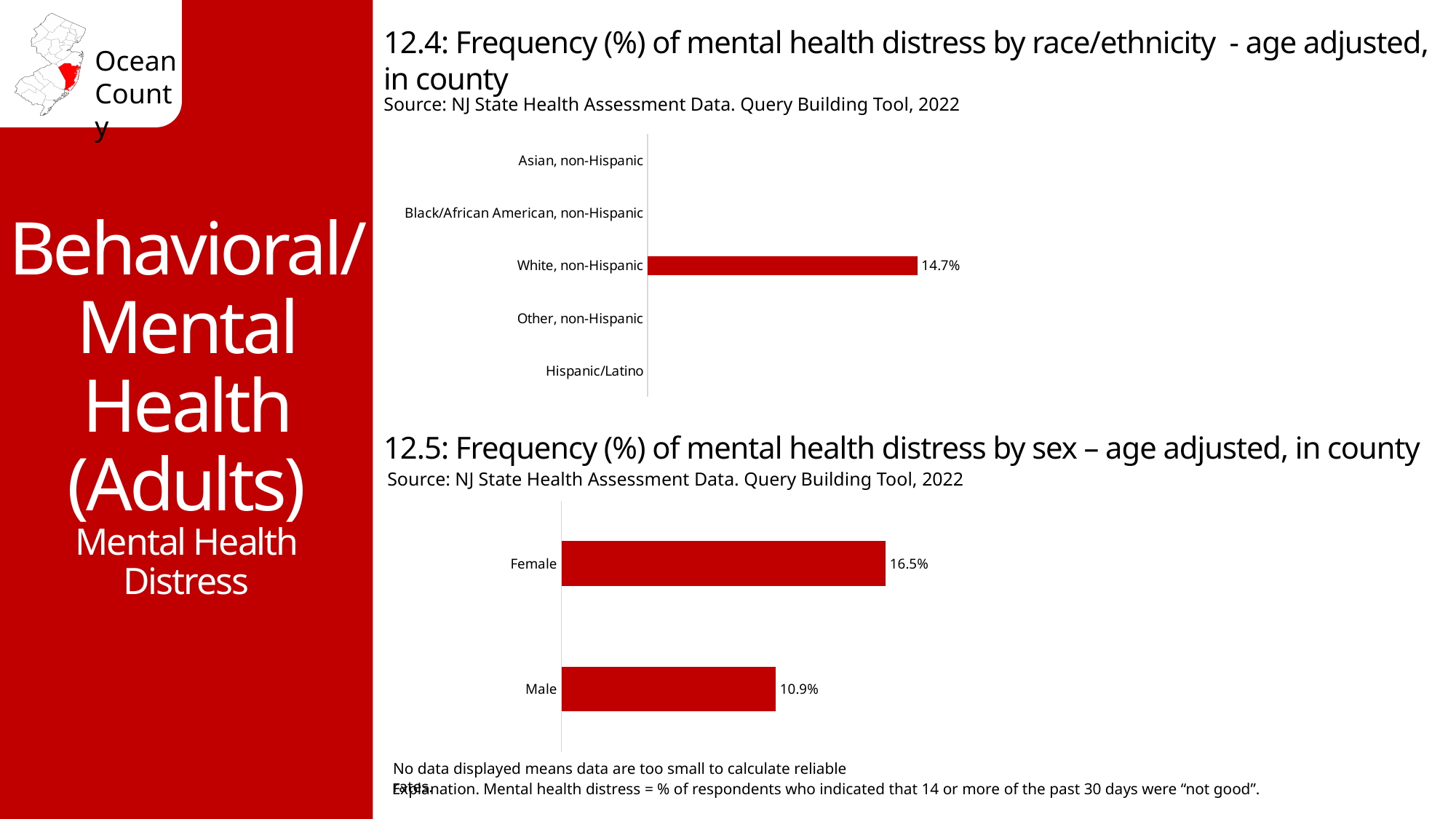
In chart 12.5 (mental health distress by sex), which sex has the lower frequency of mental health distress? Male In chart 12.5 (mental health distress by sex), how many categories are plotted? 2 In chart 12.5 (mental health distress by sex), what is the difference between the Female and Male values? 5.6% In chart 12.5 (mental health distress by sex), what is the value for Female? 16.5% In chart 12.4 (mental health distress by race/ethnicity), what kind of chart is shown? Bar chart In chart 12.4 (mental health distress by race/ethnicity), what is the value for White, non-Hispanic? 14.7% In chart 12.5 (mental health distress by sex), which sex has the higher frequency of mental health distress? Female In chart 12.5 (mental health distress by sex), what is the value for Male? 10.9% In chart 12.4 (mental health distress by race/ethnicity), which category is the only one with a bar displayed? White, non-Hispanic In chart 12.4 (mental health distress by race/ethnicity), how many race/ethnicity categories are listed on the axis? 5 Is the Female value in chart 12.5 larger than the White, non-Hispanic value in chart 12.4? Yes In chart 12.5 (mental health distress by sex), what kind of chart is shown? Bar chart